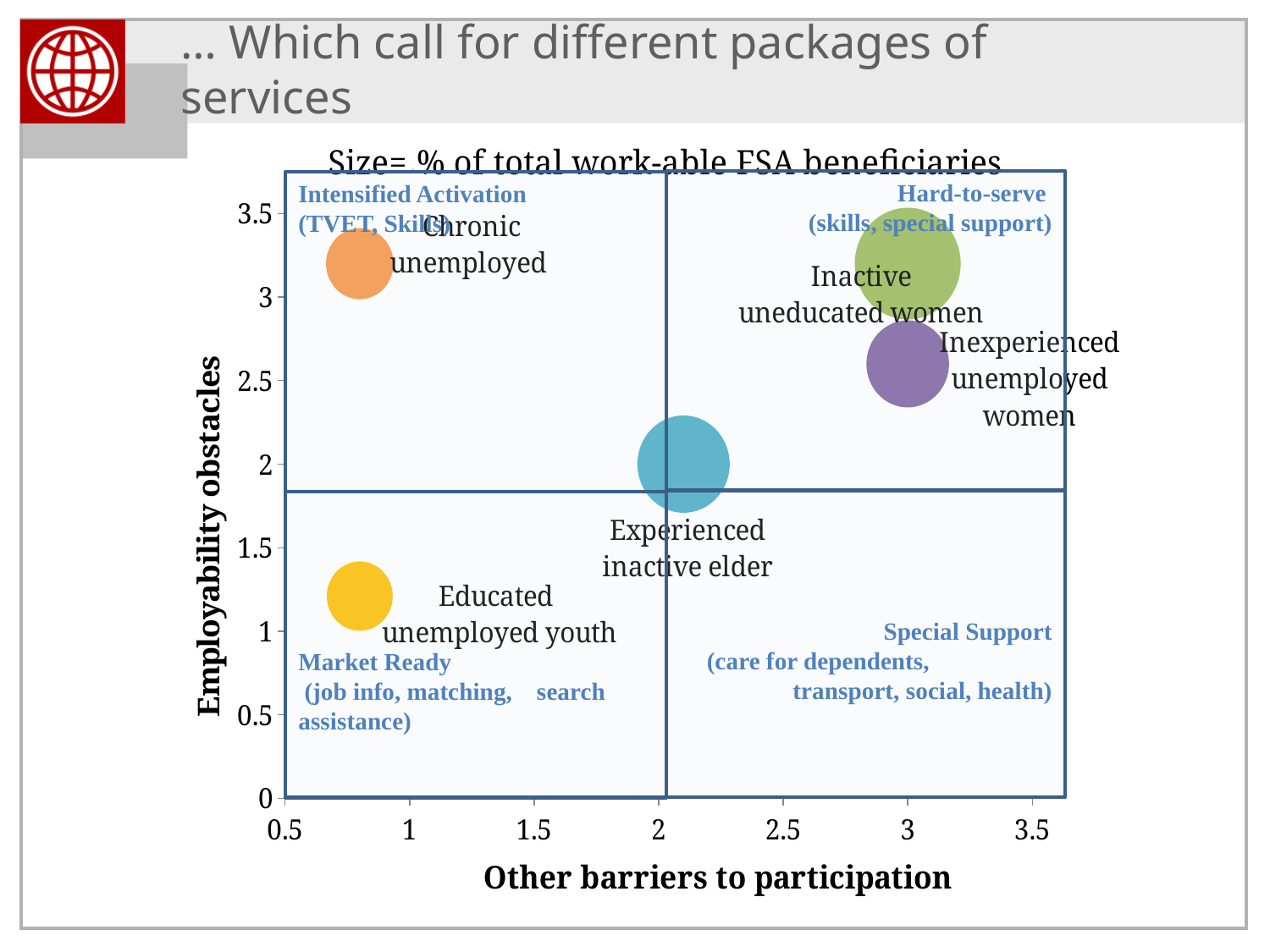
Which group has the higher employability obstacles value, Inexperienced unemployed women or Experienced inactive elder? Inexperienced unemployed women Which service package label appears in the top-right quadrant of the chart? Hard-to-serve (skills, special support) According to the chart subtitle, what does the size of each bubble represent? % of total work-able FSA beneficiaries What kind of chart is shown on the slide? bubble chart Is the other barriers to participation value for Experienced inactive elder greater or less than 1.5? greater Which group has the higher other barriers to participation value, Educated unemployed youth or Experienced inactive elder? Experienced inactive elder Which group has the lowest employability obstacles value? Educated unemployed youth Is the employability obstacles value for Inexperienced unemployed women greater or less than 3? less Is the employability obstacles value for Chronic unemployed greater or less than 3? greater How many bubbles (groups) are plotted on the chart? 5